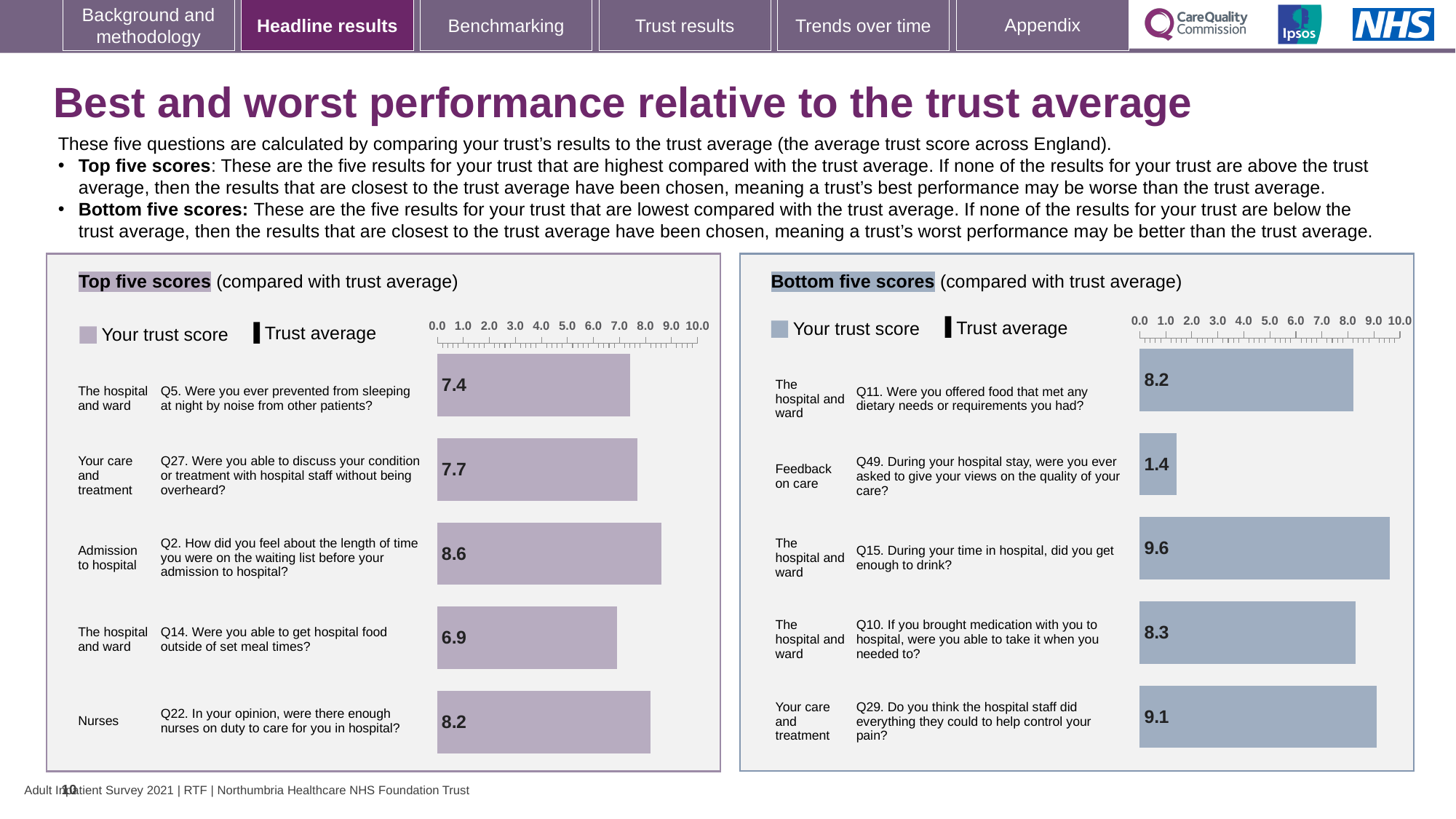
In the Bottom five scores chart, which has the larger trust score, Q10 or Q11? Q10 In the Top five scores chart, what is the difference between the trust scores for Q2 and Q14? 1.7 How many questions are plotted in the Top five scores chart? 5 What type of chart is used in the Bottom five scores panel? Bar chart In the Top five scores chart, which question has the lowest trust score? Q14 (6.9) In the Bottom five scores chart, which question has the highest trust score? Q15 (9.6) How many entries does the legend of the Top five scores chart list? 2 In the Bottom five scores chart, what is the trust score for Q49 about being asked to give your views on the quality of your care? 1.4 In the Top five scores chart, which question has the highest trust score? Q2 (8.6) In the Top five scores chart, what is the trust score for Q2 about the length of time on the waiting list before admission? 8.6 In the Bottom five scores chart, which question has the lowest trust score? Q49 (1.4) In the Top five scores chart, what is the trust score for Q22 about there being enough nurses on duty? 8.2